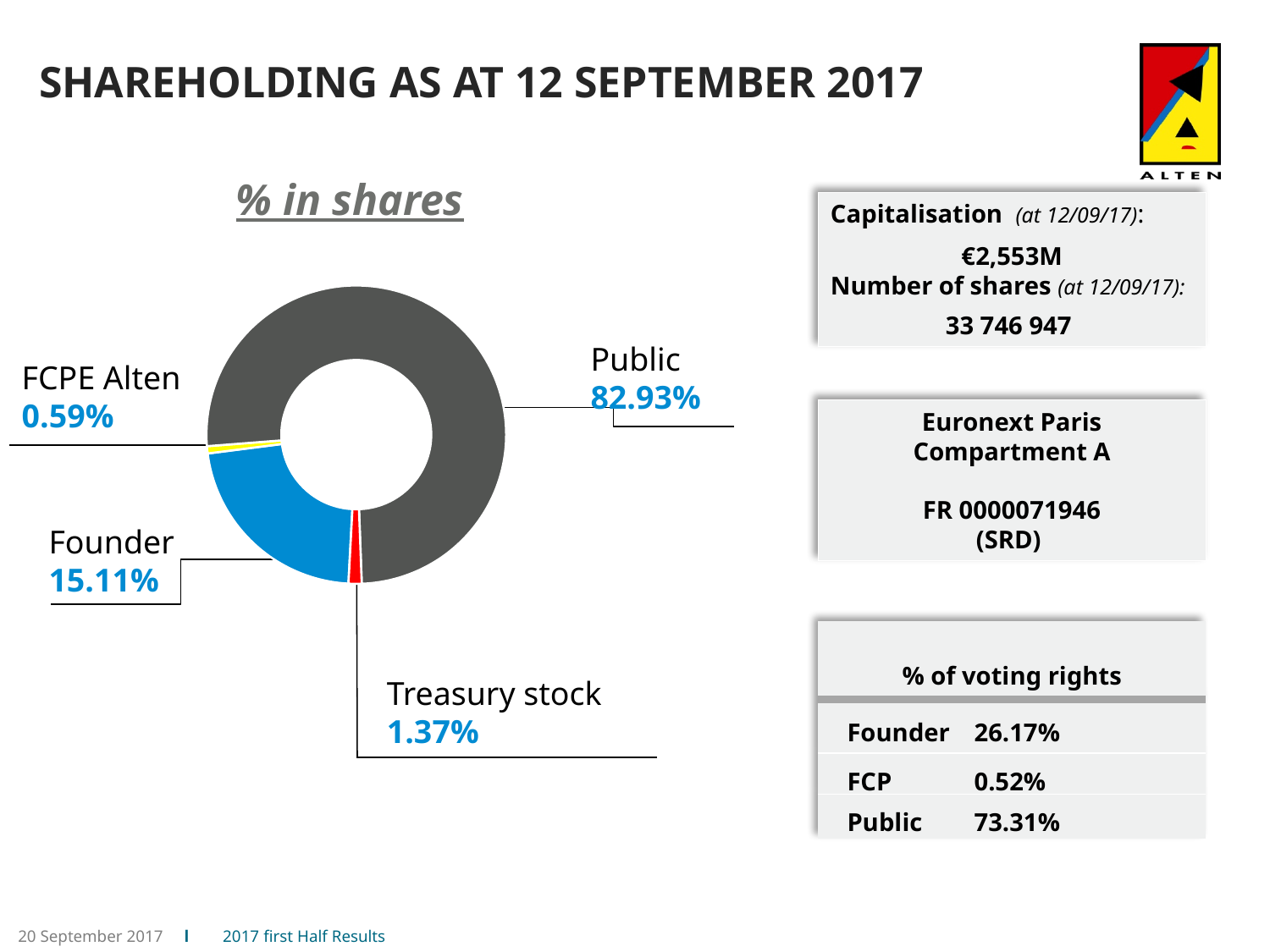
What share of shares is Treasury stock in the '% in shares' chart? 1.37% What share of shares does FCPE Alten hold in the '% in shares' chart? 0.59% How many categories are shown in the '% in shares' chart? 4 In the '% in shares' chart, what is the difference between the Public share and the Founder share? 67.82% Which category has the smallest share in the '% in shares' chart? FCPE Alten In the '% in shares' chart, what is the difference between the Treasury stock share and the FCPE Alten share? 0.78% What share of shares does the Public hold in the '% in shares' chart? 82.93% Which category has the largest share in the '% in shares' chart? Public In the '% in shares' chart, which is larger: Founder or Treasury stock? Founder What share of shares does the Founder hold in the '% in shares' chart? 15.11% What colour is the Founder slice in the '% in shares' chart? Blue What kind of chart is the '% in shares' chart? Pie chart (donut)